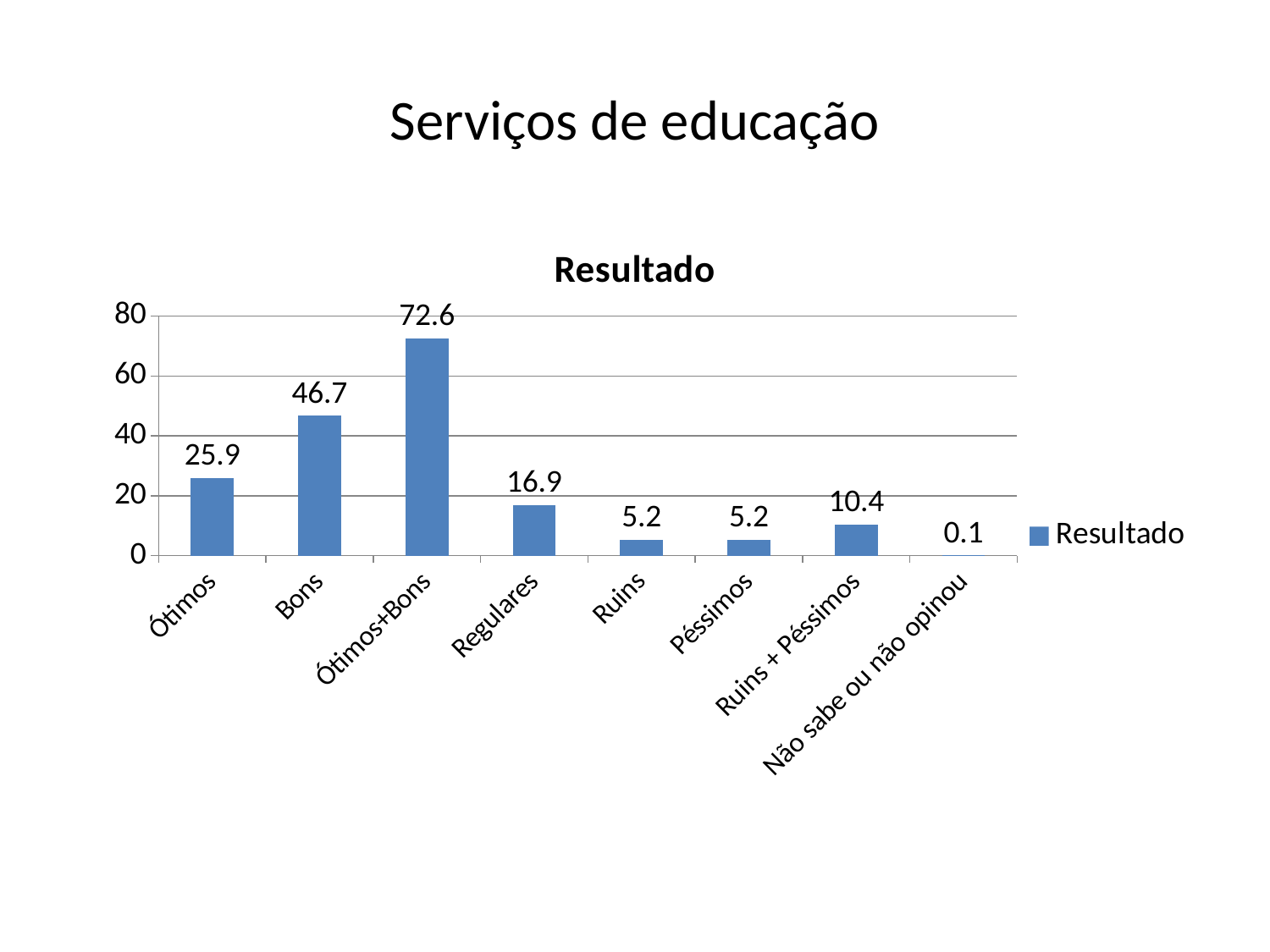
Which category has the highest value? Ótimos+Bons Which category has the lowest value? Não sabe ou não opinou Which is larger, the value for Regulares or the value for Ruins + Péssimos? Regulares What is the value for Regulares? 16.9 How many series does the legend list? 1 What kind of chart is shown? bar chart Is the value for Bons greater or less than 40? greater What is the title of the chart? Resultado How many categories are shown on the x axis? 8 What is the value for Ótimos? 25.9 What is the value for Não sabe ou não opinou? 0.1 What is the difference between the values for Bons and Ótimos? 20.8